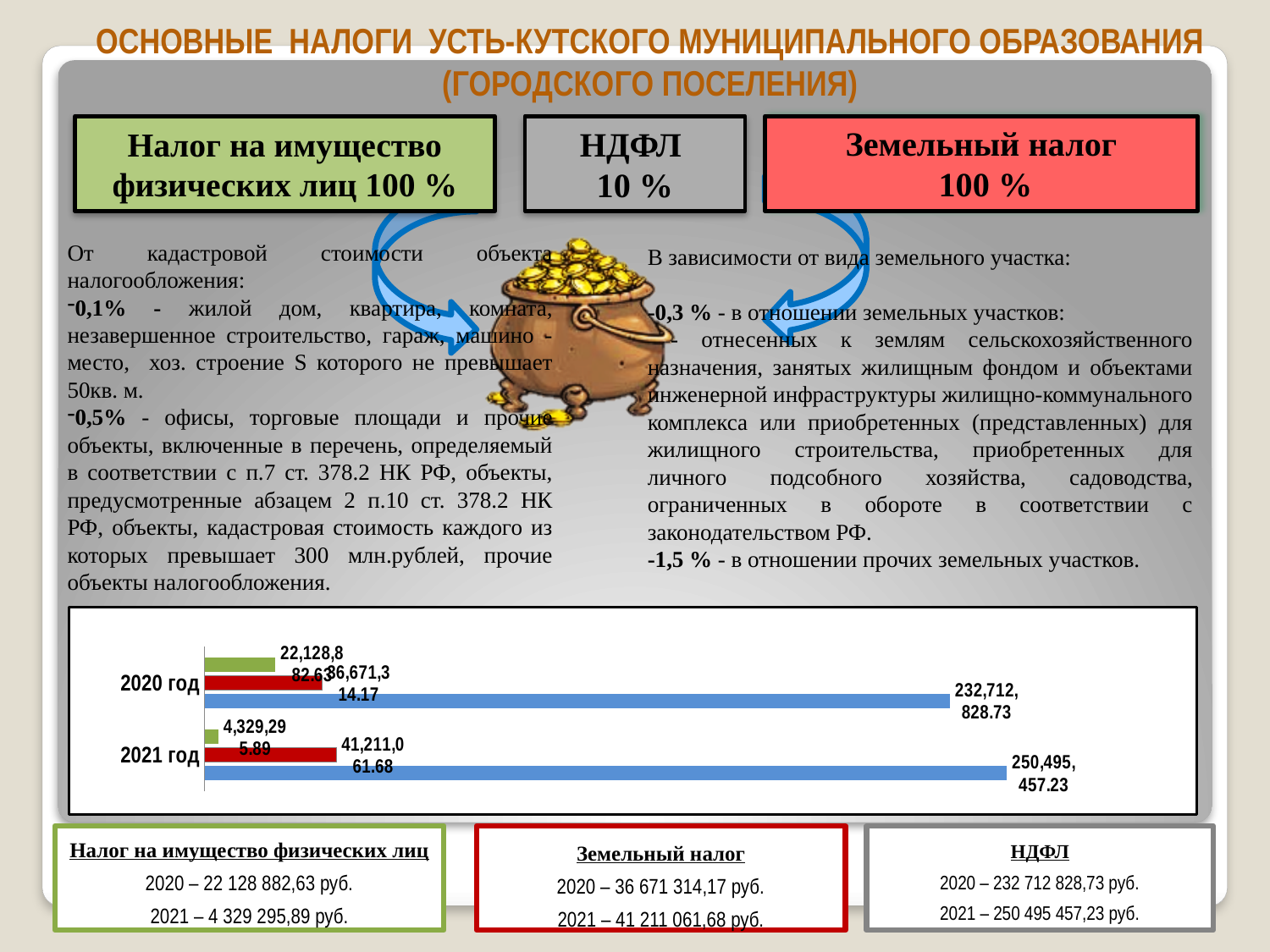
What value is labelled on the red bar for 2021 год? 41,211,061.68 By how much does the blue bar value for 2021 год exceed the blue bar value for 2020 год? 17,782,628.50 What value is labelled on the blue bar for 2021 год? 250,495,457.23 How many year categories does the chart show? 2 Do the blue (НДФЛ) bar values rise or fall from 2020 год to 2021 год? rise What value is labelled on the blue bar for 2020 год? 232,712,828.73 What kind of chart is shown on the slide? bar chart What value is labelled on the red bar for 2020 год? 36,671,314.17 How many bars are plotted for each year in the chart? 3 Which colour bar is the longest in the chart for both years? blue In the chart, is the green bar for 2020 год longer or shorter than the green bar for 2021 год? longer In the chart, which year has the longer blue (НДФЛ) bar? 2021 год